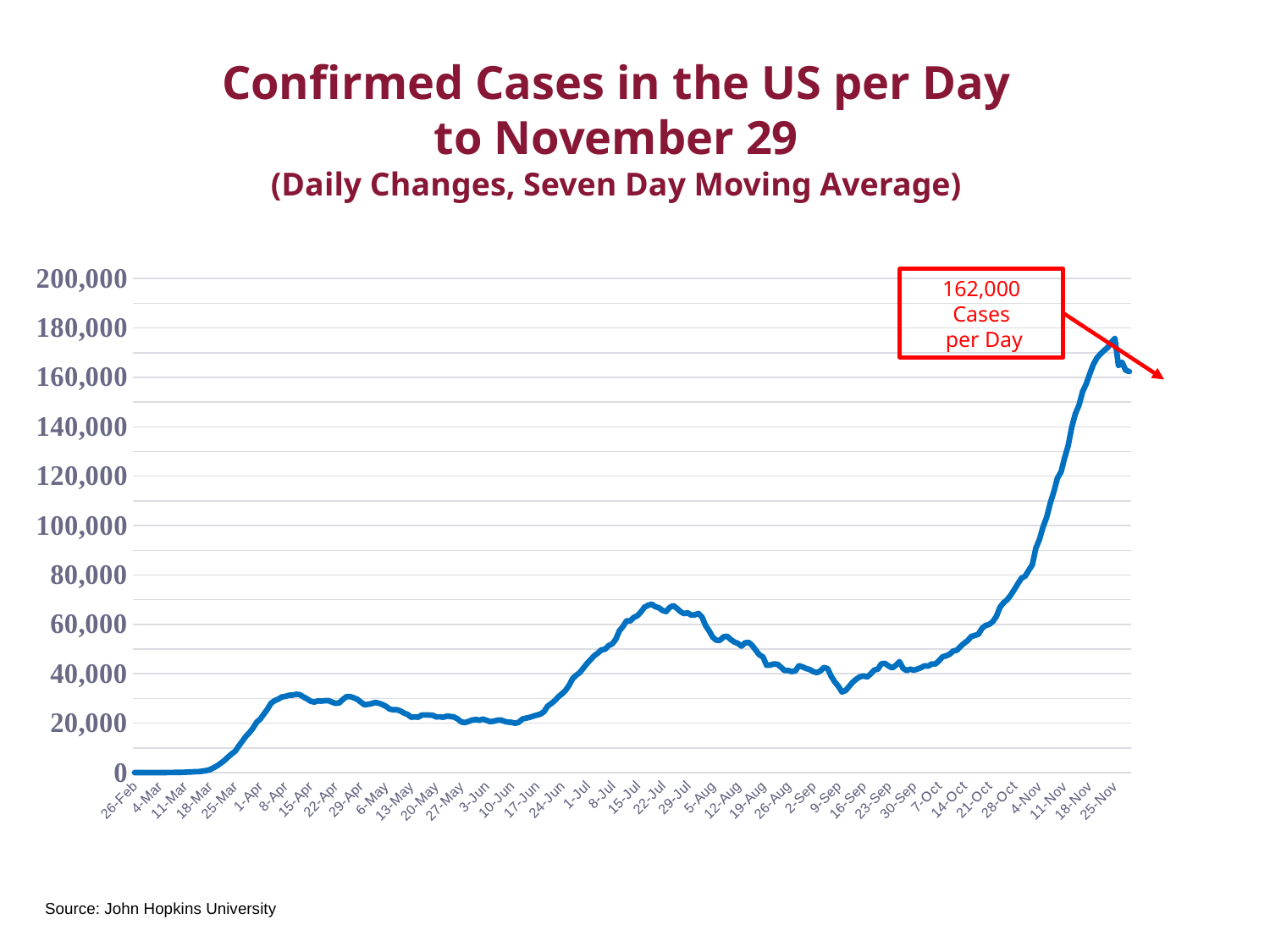
What source is cited for the chart's data? John Hopkins University Between 7-Oct and 18-Nov, does the line rise or fall? rise According to the annotation, how many confirmed cases per day were there at the end of the series (November 29)? 162,000 Is the value around 22-Jul larger or smaller than the value around 8-Apr? larger Is the value at 26-Feb greater or less than 20,000? less In which part of the period does the line reach its highest value? late November Is the value around 8-Apr greater or less than 20,000? greater Is the value around 9-Sep greater or less than 40,000? less What kind of chart is shown on the slide? line chart Between 29-Jul and 9-Sep, does the line rise or fall? fall